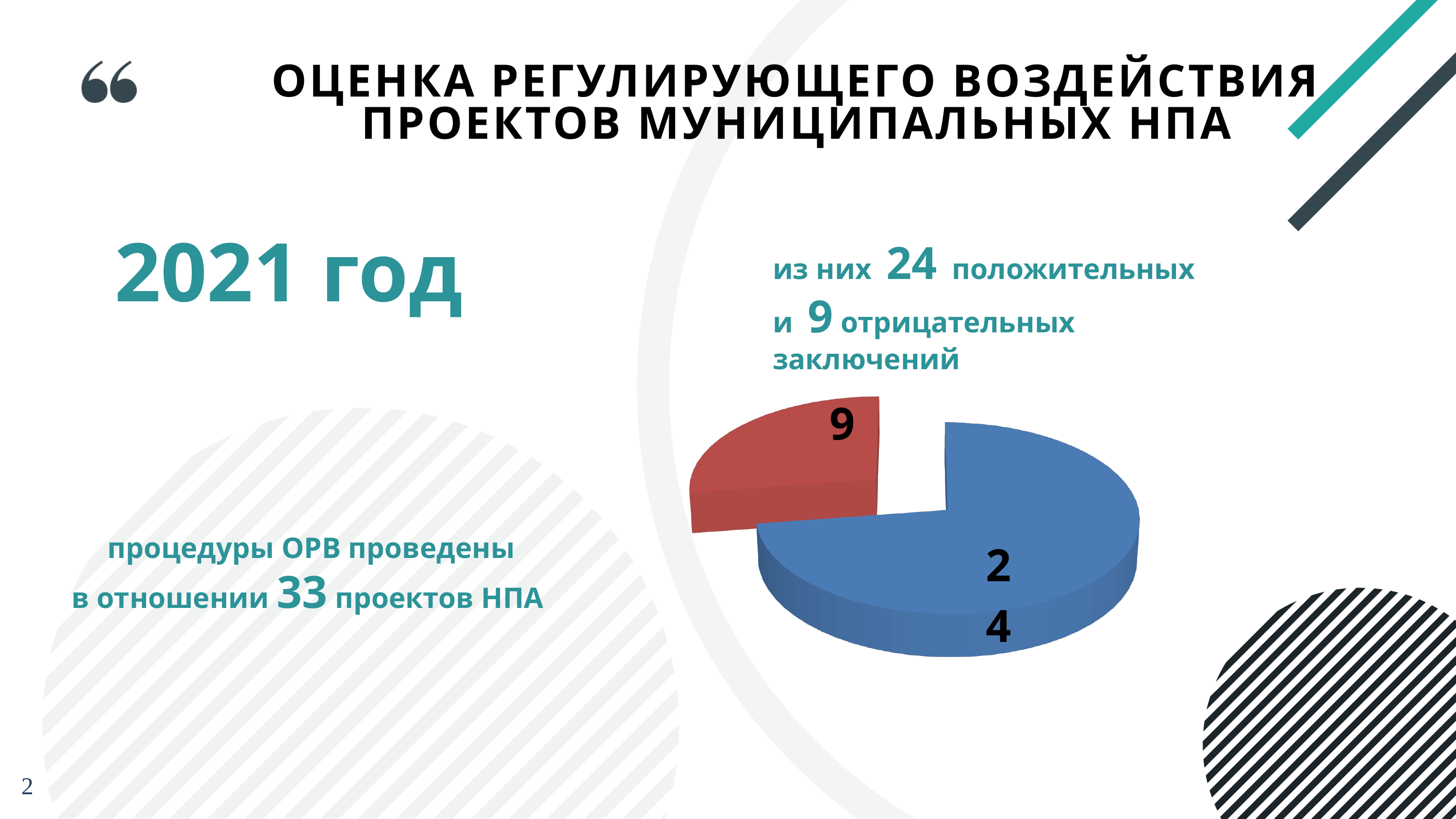
Which slice of the pie chart is the largest? 24 (blue, positive conclusions) How many negative conclusions (отрицательных) does the pie chart show? 9 What value is shown on the blue slice of the pie chart? 24 What colour is the slice labeled 9 in the pie chart? red What value is shown on the red slice of the pie chart? 9 What is the difference between the two slice values in the pie chart? 15 How many slices does the pie chart have? 2 Which is larger in the pie chart, the blue slice or the red slice? the blue slice What is the total of the two slice values in the pie chart? 33 How many positive conclusions (положительных) does the pie chart show? 24 Which slice of the pie chart is the smallest? 9 (red, negative conclusions) What kind of chart is shown on the slide? pie chart